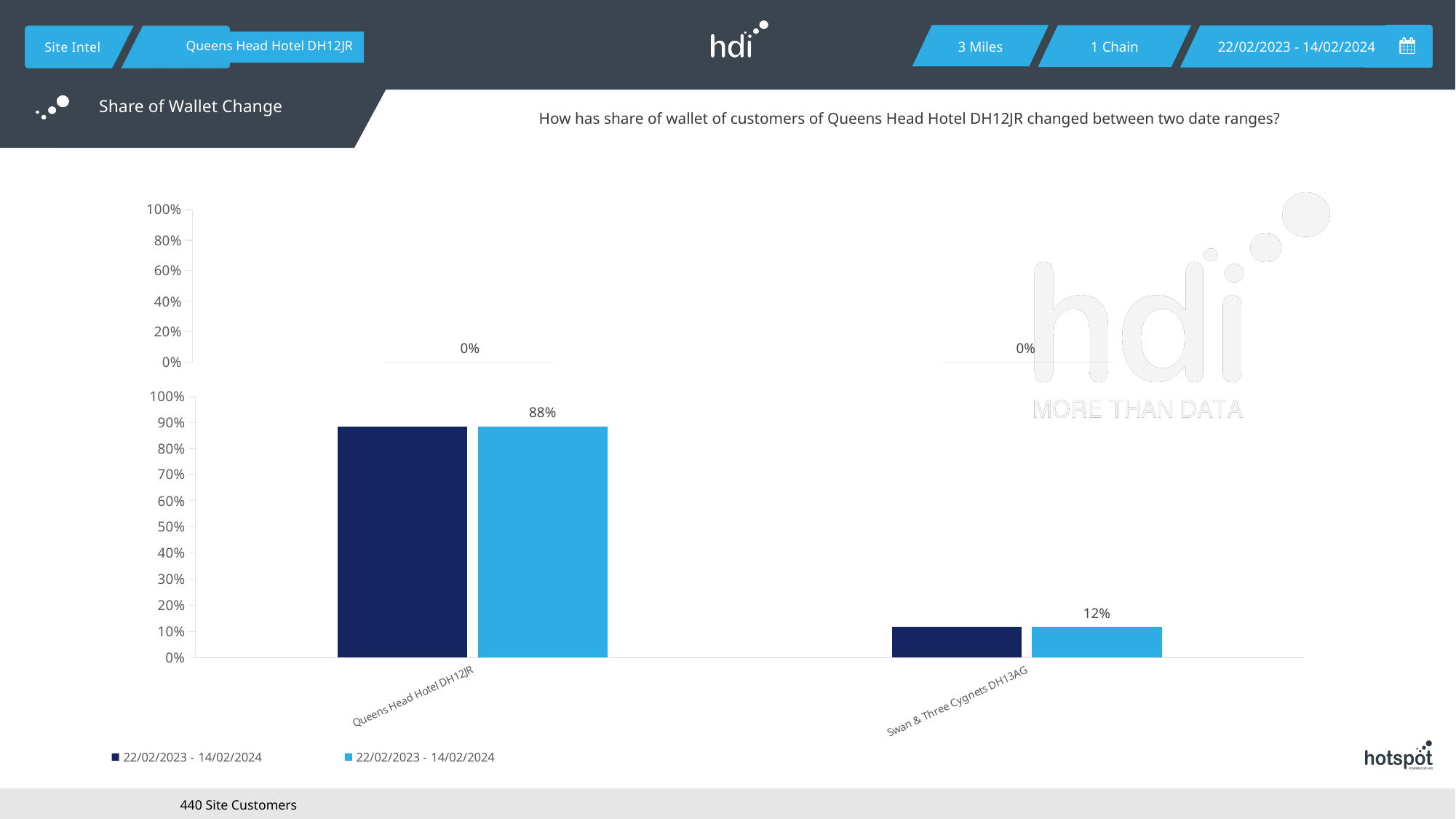
In the bottom chart, what share of wallet value is labelled for Swan & Three Cygnets DH13AG? 12% What kind of chart is the bottom chart? bar chart How many categories are shown on the x axis of the bottom chart? 2 How many series does the legend of the bottom chart list? 2 In the bottom chart, what is the difference between the labelled values for Queens Head Hotel DH12JR and Swan & Three Cygnets DH13AG? 76% In the bottom chart, which category has the highest share of wallet? Queens Head Hotel DH12JR In the bottom chart, which category has the lowest share of wallet? Swan & Three Cygnets DH13AG What is the title of the slide section containing the charts? Share of Wallet Change In the bottom chart, what share of wallet value is labelled for Queens Head Hotel DH12JR? 88% In the top chart, what change value is labelled for Queens Head Hotel DH12JR? 0% In the bottom chart, is the value for Queens Head Hotel DH12JR greater or less than 80%? greater In the bottom chart, is the value for Swan & Three Cygnets DH13AG greater or less than 20%? less